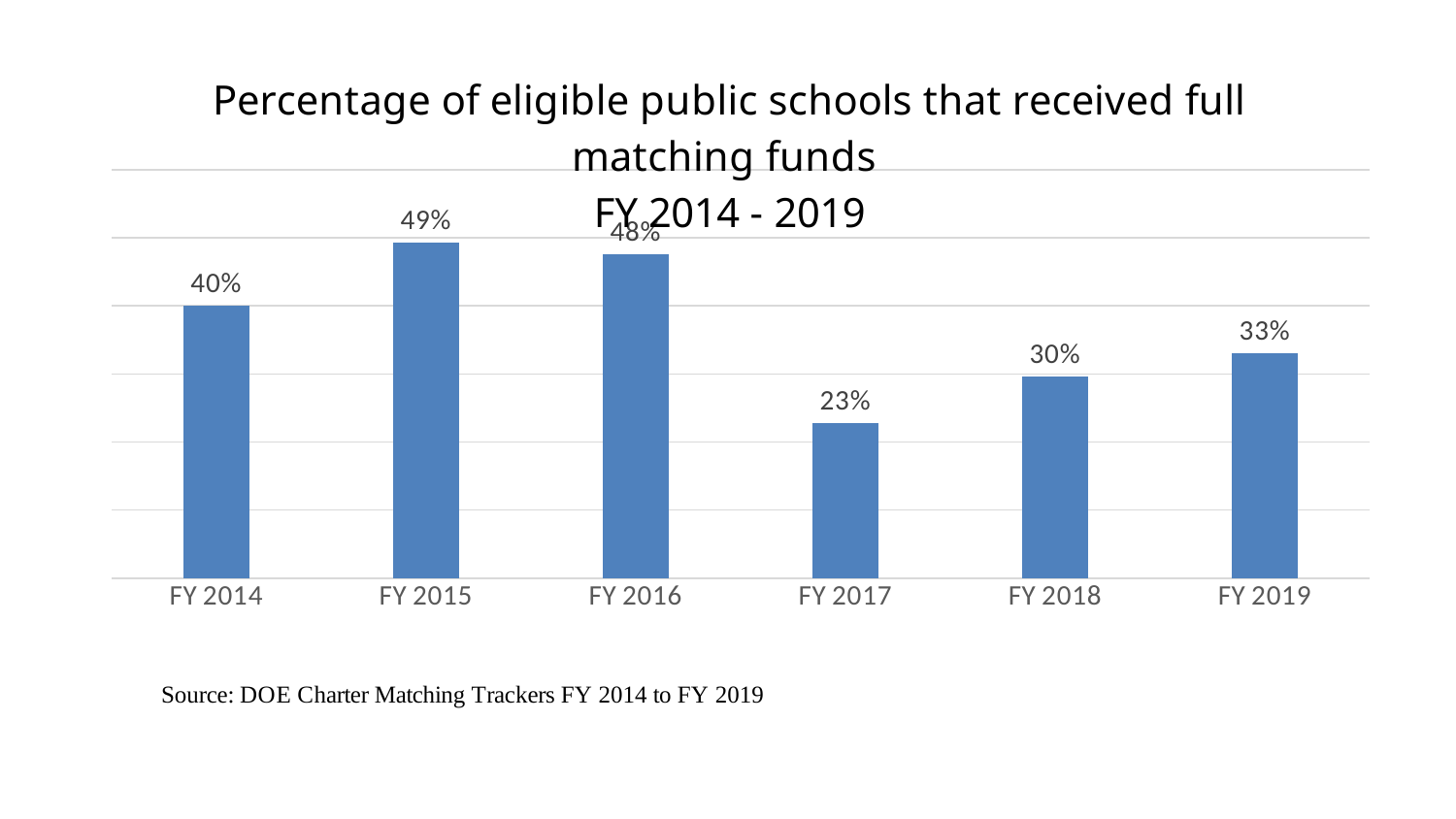
What percentage of eligible public schools received full matching funds in FY 2014? 40% What source is cited below the chart? DOE Charter Matching Trackers FY 2014 to FY 2019 What is the value shown for FY 2018? 30% What kind of chart is shown on the slide? Bar chart What is the value shown for FY 2017? 23% How many fiscal years are shown on the chart? 6 What is the value shown for FY 2019? 33% Which fiscal year has the highest percentage of eligible public schools receiving full matching funds? FY 2015 Which is larger, the value for FY 2014 or the value for FY 2019? FY 2014 What is the difference between the FY 2019 value and the FY 2018 value? 3% Which fiscal year has the lowest percentage of eligible public schools receiving full matching funds? FY 2017 What is the difference between the FY 2015 value and the FY 2017 value? 26%